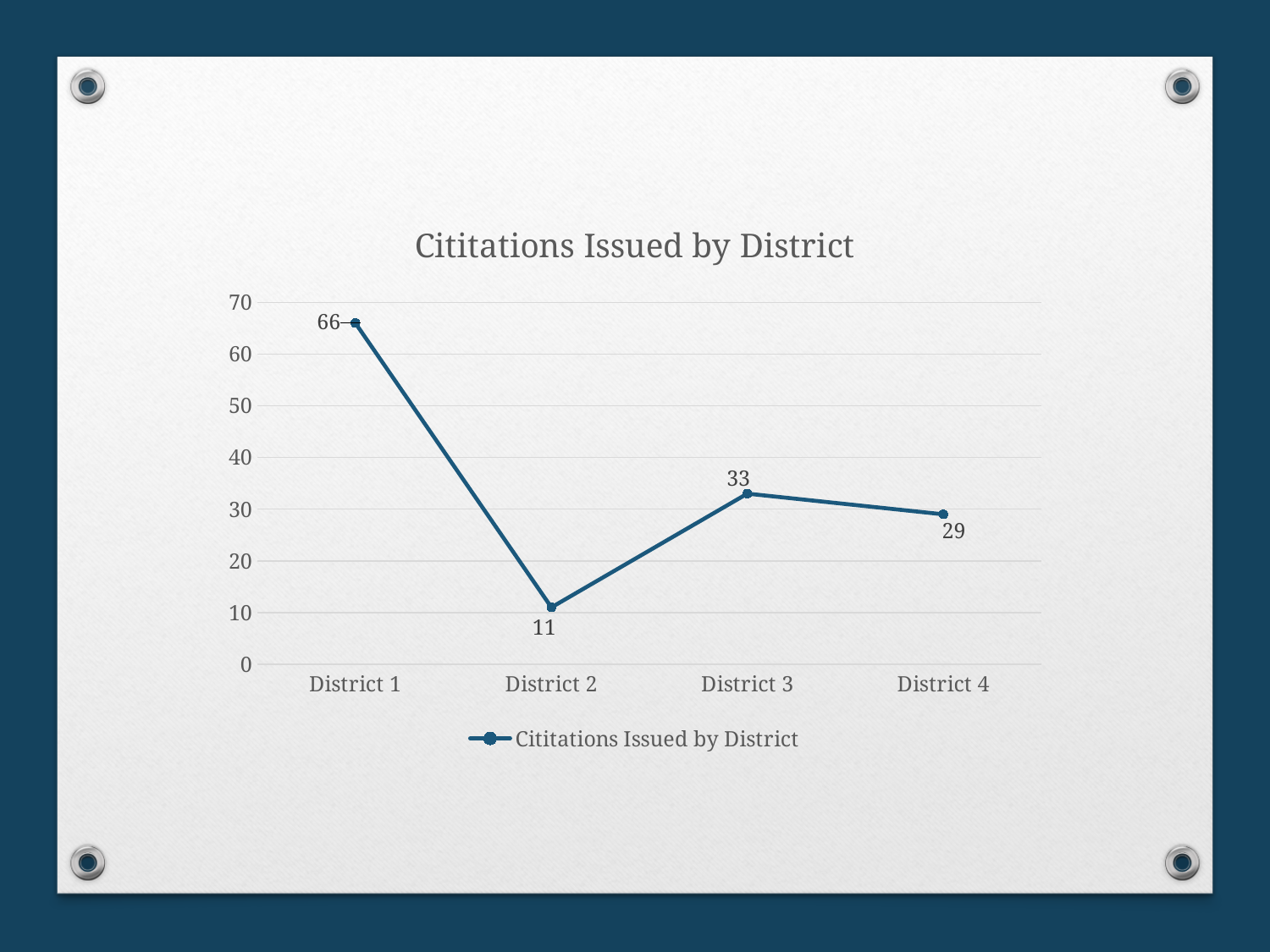
What is the difference between the values for District 1 and District 2? 55 What is the title of the chart? Cititations Issued by District Which is larger, the value for District 3 or the value for District 4? District 3 How many districts are plotted on the chart? 4 Which district has the lowest number of citations issued? District 2 What is the value for District 3? 33 What is the value for District 1? 66 What kind of chart is shown on the slide? Line chart What is the value for District 2? 11 Which district has the highest number of citations issued? District 1 What is the difference between the values for District 3 and District 4? 4 What is the value for District 4? 29